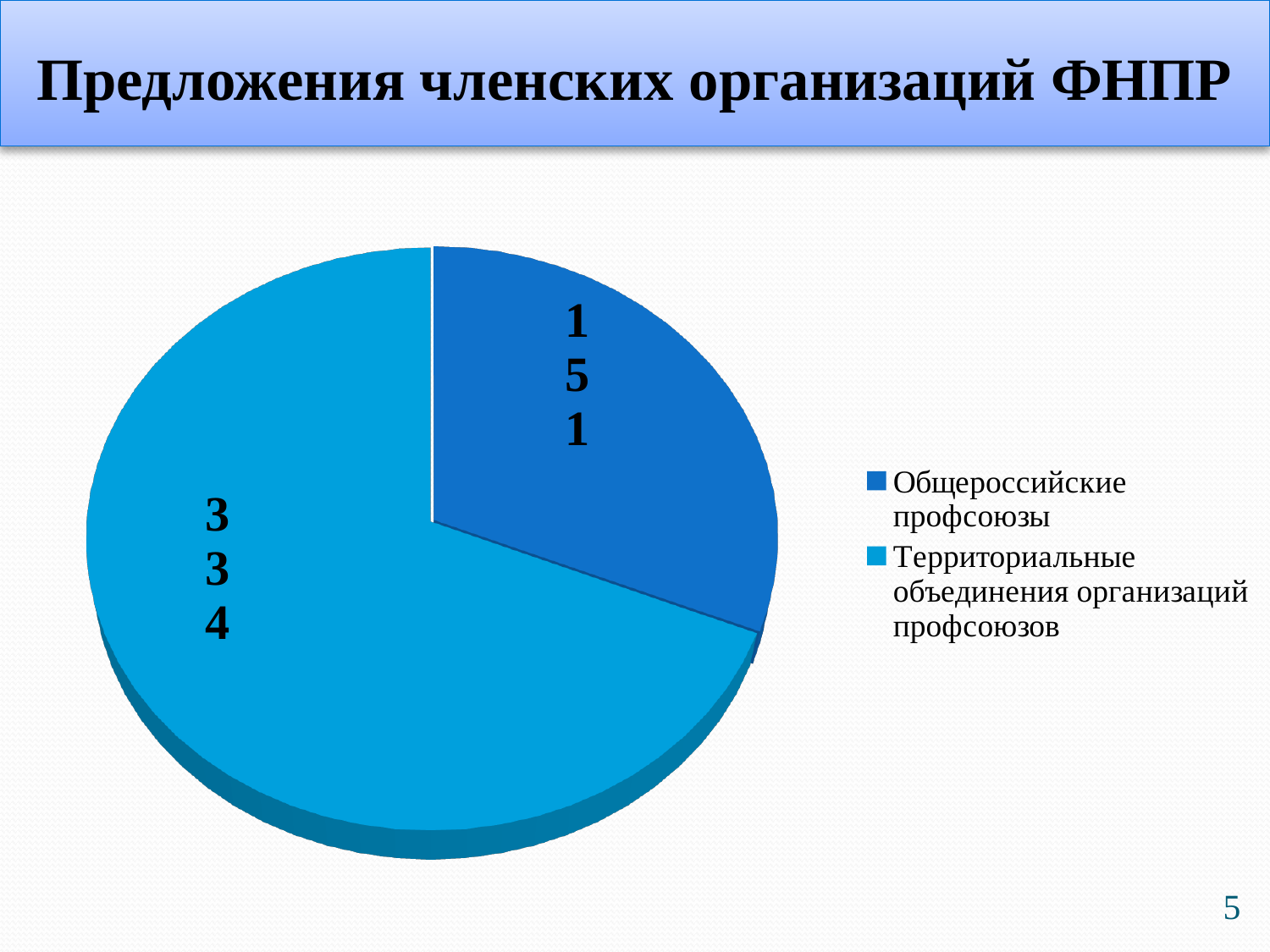
What kind of chart is shown on the slide? Pie chart Which category has the largest slice of the pie? Территориальные объединения организаций профсоюзов What is the difference between the values for Территориальные объединения организаций профсоюзов and Общероссийские профсоюзы? 183 How many slices does the pie chart have? 2 What share of the pie does Общероссийские профсоюзы represent, to the nearest whole percent? 31% What is the title of the slide containing the chart? Предложения членских организаций ФНПР Which category has the smallest slice of the pie? Общероссийские профсоюзы What is the value for Общероссийские профсоюзы? 151 Which is larger: the value for Общероссийские профсоюзы or the value for Территориальные объединения организаций профсоюзов? Территориальные объединения организаций профсоюзов What is the total of all slices in the pie chart? 485 What is the value for Территориальные объединения организаций профсоюзов? 334 How many entries does the legend list? 2